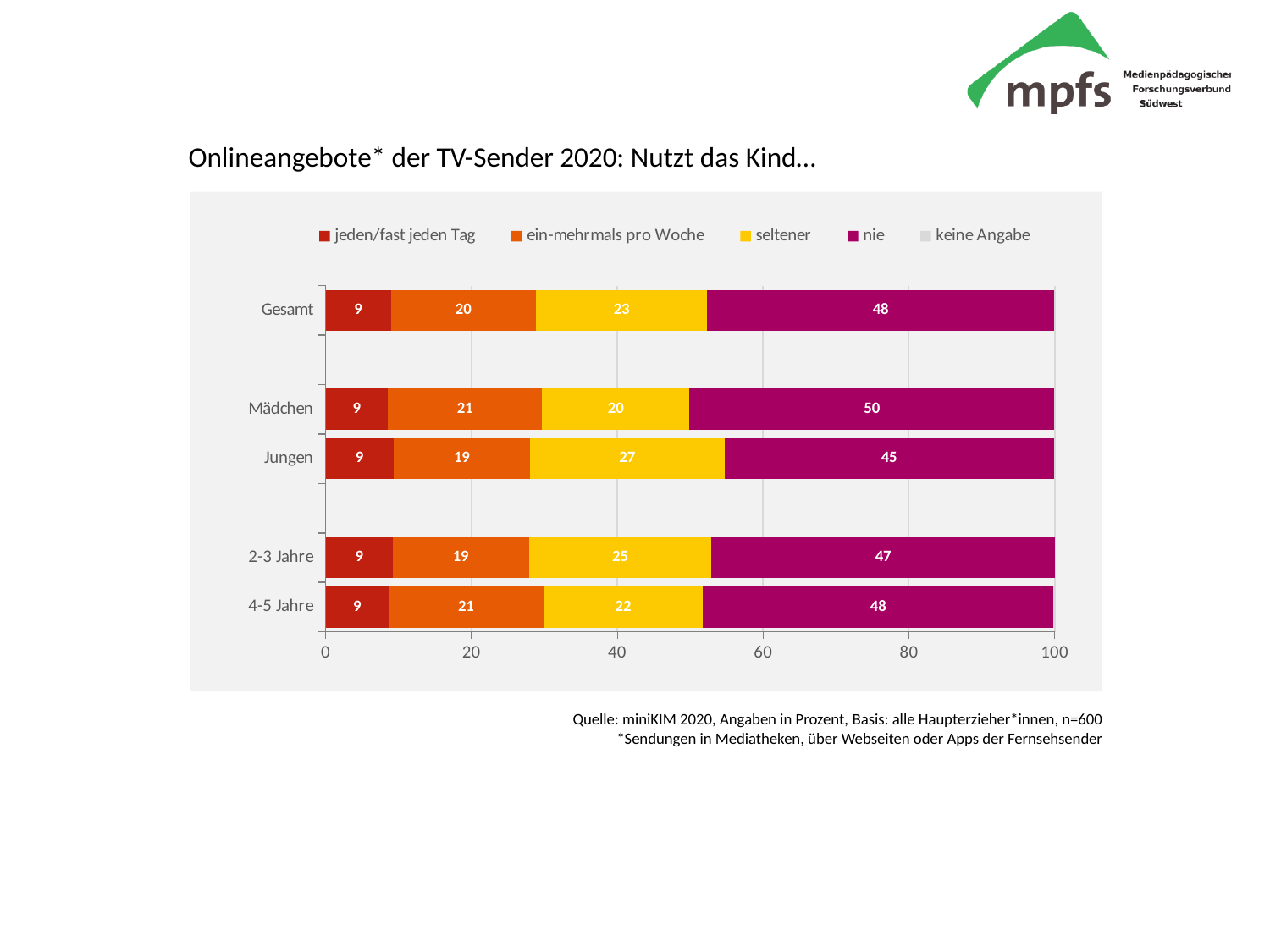
Which category has the lowest value for "seltener"? Mädchen Which is larger: the "seltener" value for 2-3 Jahre or for 4-5 Jahre? 2-3 Jahre What is the value for "ein-mehrmals pro Woche" in the Gesamt bar? 20 Which category has the highest value for "nie"? Mädchen What is the value for "nie" in the Mädchen bar? 50 What is the total of the labelled segments in the Jungen bar? 100 What kind of chart is shown on the slide? Stacked bar chart How many series does the legend list? 5 How many categories are shown on the y axis? 5 What is the value for "jeden/fast jeden Tag" in the 4-5 Jahre bar? 9 What is the value for "seltener" in the Jungen bar? 27 What is the difference between the "nie" values for Mädchen and Jungen? 5